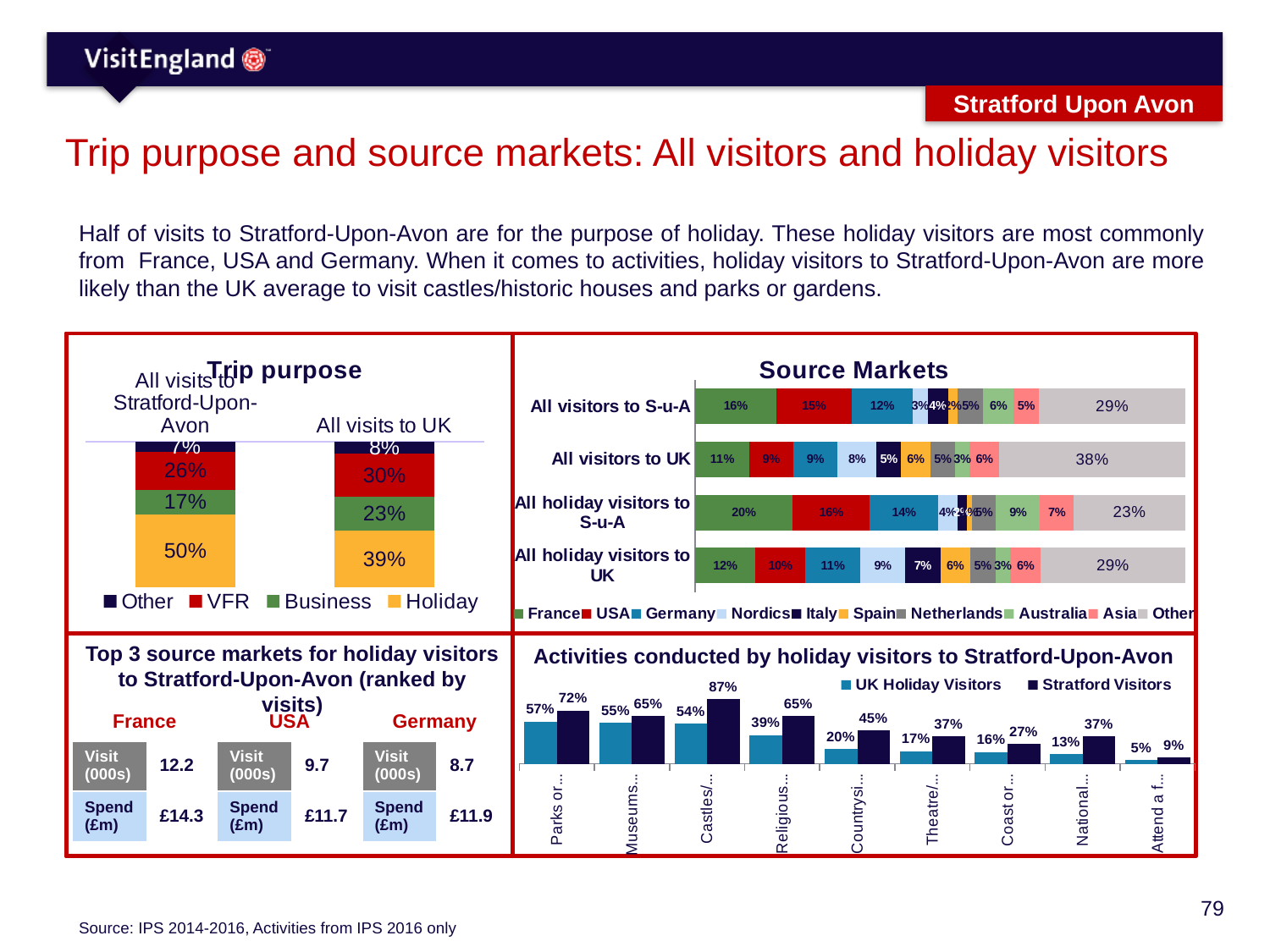
In the Activities chart, what percentage of Stratford Visitors visited Castles? 87% In the Source Markets chart, what share of all holiday visitors to S-u-A come from France? 20% In the Trip purpose chart, how many series does the legend list? 4 In the Source Markets chart, what share of all visitors to UK fall in the Other category? 38% In the Activities chart, which activity has the highest value for Stratford Visitors? Castles In the Source Markets chart, how many source market series does the legend list? 10 What type of chart is the Activities conducted by holiday visitors to Stratford-Upon-Avon chart? Bar chart In the Activities chart, what is the difference between Stratford Visitors and UK Holiday Visitors for Countryside? 25% In the Trip purpose chart, what is the difference between the VFR share for all visits to UK and for all visits to Stratford-Upon-Avon? 4% In the Trip purpose chart, what share of all visits to UK are for Business? 23% In the Trip purpose chart, what share of all visits to Stratford-Upon-Avon are for Holiday? 50% In the Source Markets chart, which is larger: the USA share of all visitors to S-u-A or the USA share of all visitors to UK? All visitors to S-u-A